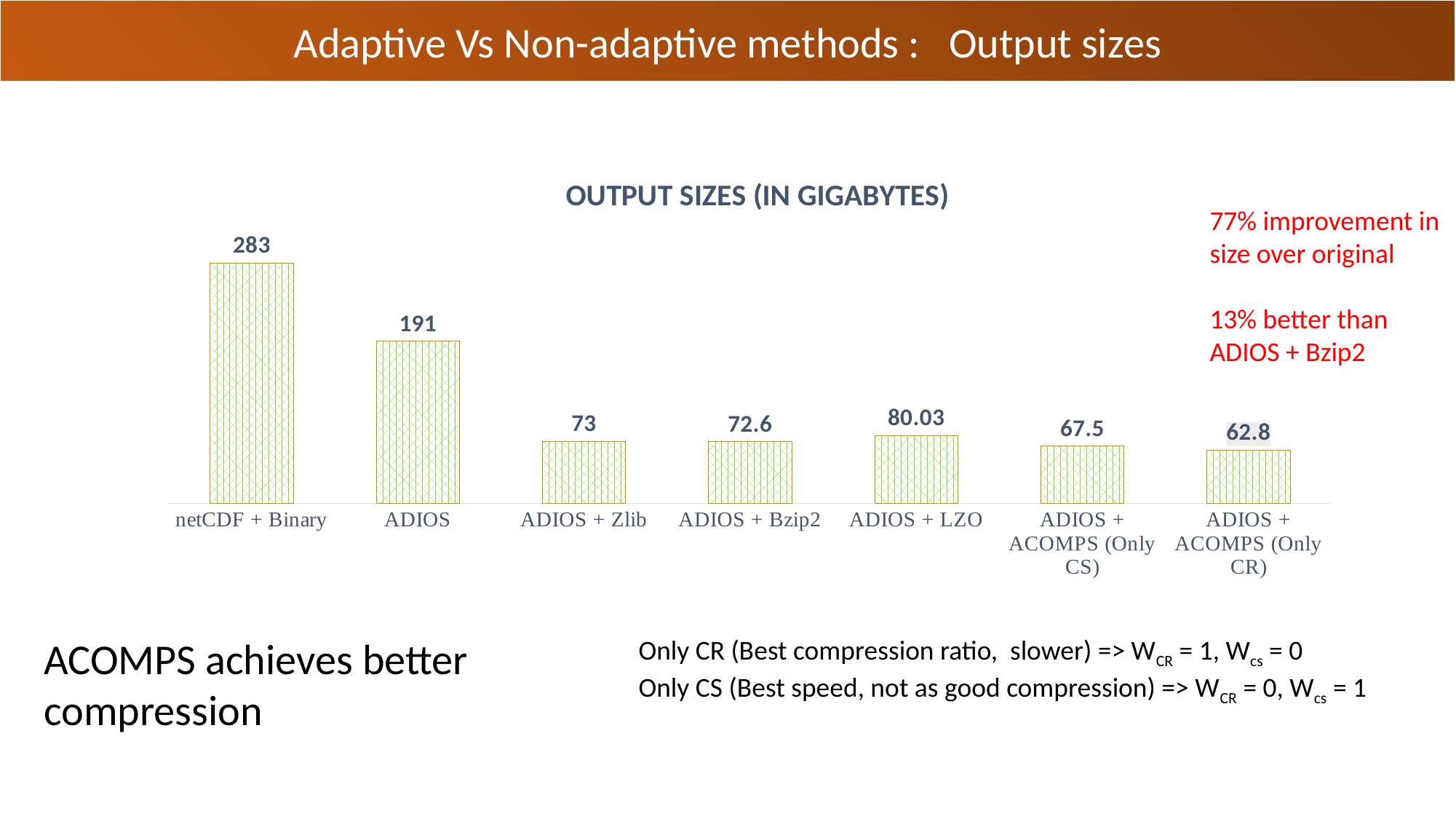
How many categories are shown in the chart? 7 What type of chart is shown on the slide? Bar chart Which category has the smallest output size? ADIOS + ACOMPS (Only CR) What is the output size for netCDF + Binary? 283 What is the difference in output size between ADIOS + ACOMPS (Only CS) and ADIOS + ACOMPS (Only CR)? 4.7 What is the output size for ADIOS + ACOMPS (Only CR)? 62.8 What is the title of the chart? OUTPUT SIZES (IN GIGABYTES) What is the difference in output size between netCDF + Binary and ADIOS? 92 What is the output size for ADIOS + Bzip2? 72.6 Which category has the largest output size? netCDF + Binary Which has a larger output size, ADIOS + Zlib or ADIOS + LZO? ADIOS + LZO What is the output size for ADIOS + LZO? 80.03